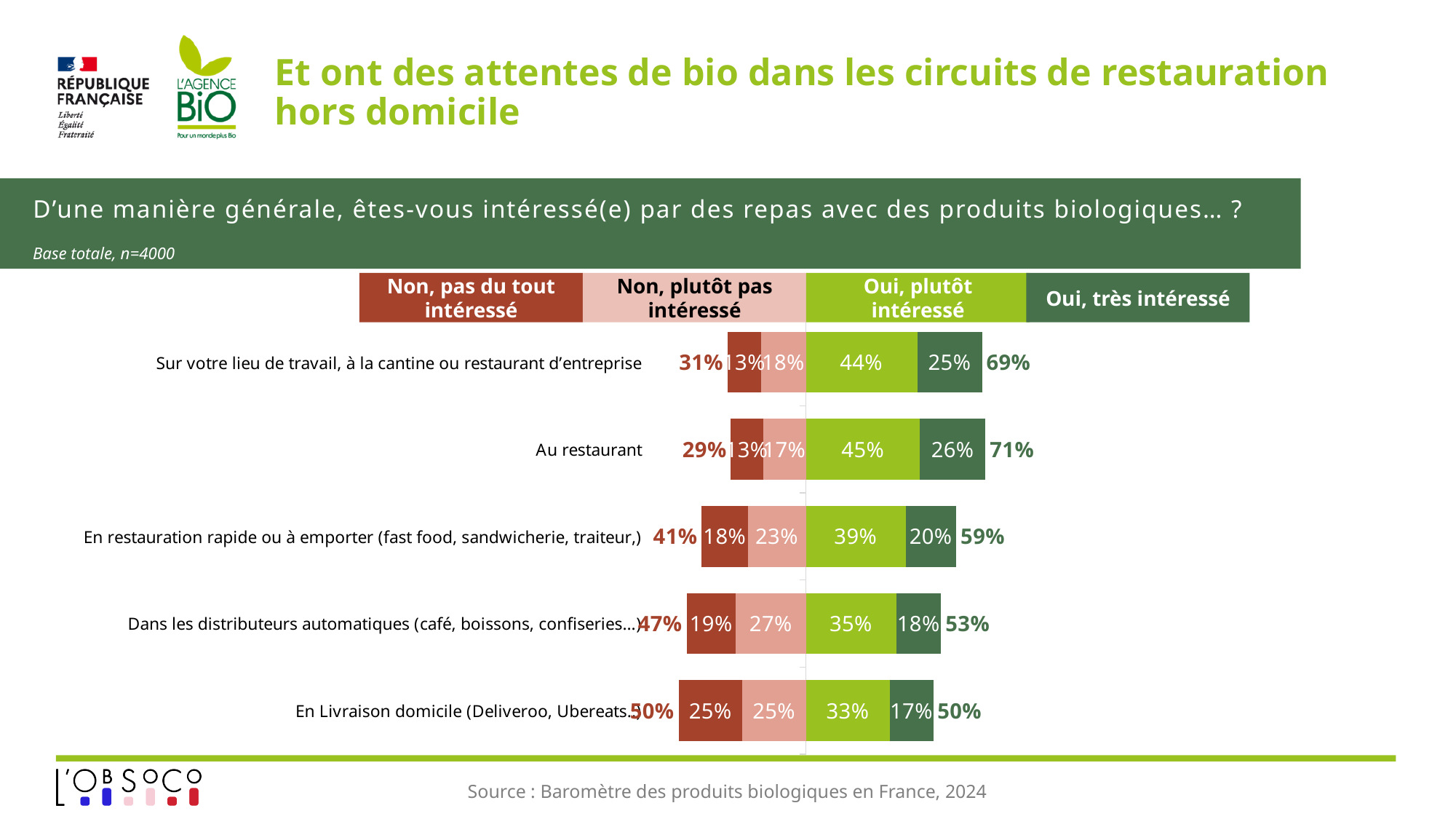
Which category has the lowest "Oui, plutôt intéressé" value? En Livraison domicile (Deliveroo, Ubereats...) How many series does the legend list? 4 How many categories (restaurant channels) are shown in the chart? 5 What percentage of respondents are "Oui, plutôt intéressé" for "Au restaurant"? 45% Which category has the highest "Oui, très intéressé" value? Au restaurant Which colour represents the "Oui, très intéressé" series in the legend? Dark green Which is larger: the "Oui, plutôt intéressé" value for "Sur votre lieu de travail, à la cantine ou restaurant d'entreprise" or for "En restauration rapide ou à emporter"? Sur votre lieu de travail, à la cantine ou restaurant d'entreprise What is the difference between the "Non, plutôt pas intéressé" values for "Dans les distributeurs automatiques" and "Au restaurant"? 10 percentage points What is the combined share of "Oui, plutôt intéressé" and "Oui, très intéressé" for "En restauration rapide ou à emporter (fast food, sandwicherie, traiteur,)"? 59% What is the "Non, pas du tout intéressé" value for "En Livraison domicile (Deliveroo, Ubereats...)"? 25% What kind of chart is shown on the slide? Stacked bar chart What is the "Oui, très intéressé" value for "Dans les distributeurs automatiques (café, boissons, confiseries...)"? 18%